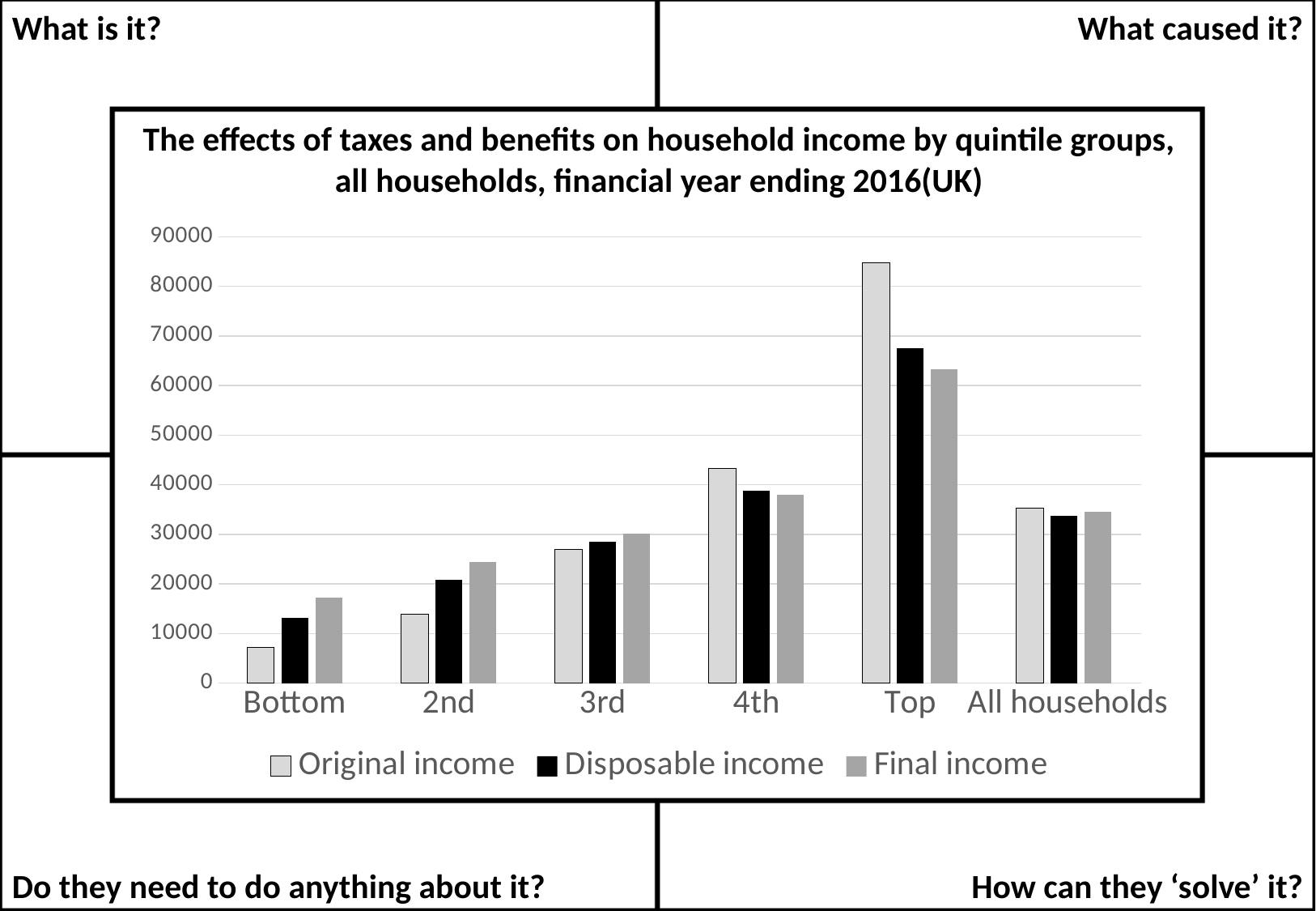
Which category has the lowest Original income? Bottom How many series does the legend list? 3 Is the Final income value for Top greater or less than 70000? less Is the Original income value for Top greater or less than 80000? greater What kind of chart is shown on the slide? bar chart Is the Disposable income value for Bottom greater or less than 10000? greater What are the three series named in the legend? Original income, Disposable income, Final income Which category has the highest Original income? Top For the Top quintile, which is larger: Original income or Final income? Original income For the Bottom quintile, which is larger: Original income or Final income? Final income Does Original income rise or fall from Bottom to Top across the quintile groups? rise How many categories are shown on the x axis? 6